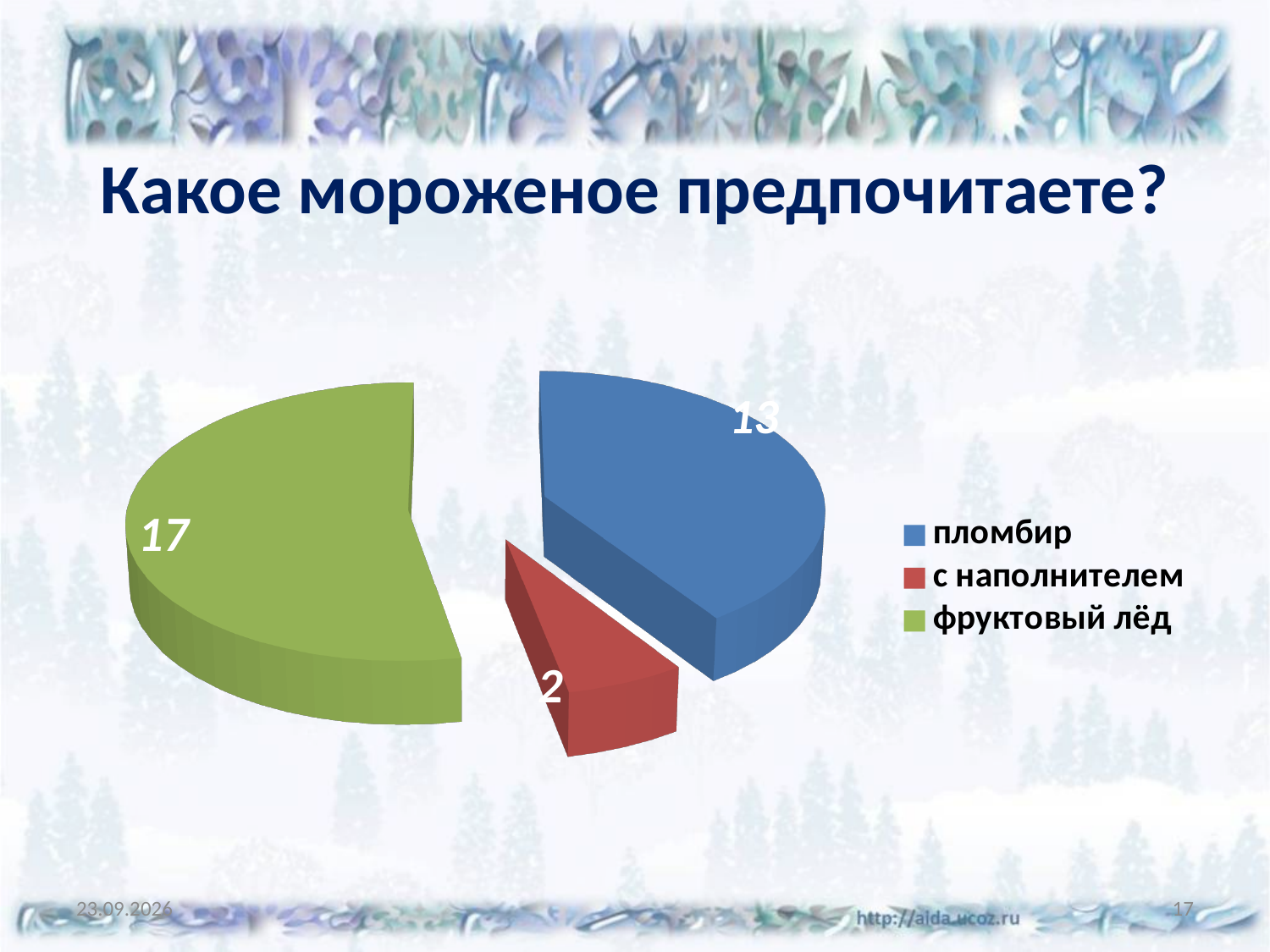
What is the title of the chart on the slide? Какое мороженое предпочитаете? What is the total of all slices in the pie chart? 32 What is the difference between the values for пломбир and с наполнителем? 11 What is the difference between the values for фруктовый лёд and пломбир? 4 What kind of chart is shown on the slide? pie chart How many categories does the pie chart have? 3 Which is larger, the value for пломбир or the value for фруктовый лёд? фруктовый лёд Which category has the lowest value? с наполнителем What is the value for пломбир? 13 What is the value for с наполнителем? 2 What is the value for фруктовый лёд? 17 Which category has the highest value? фруктовый лёд